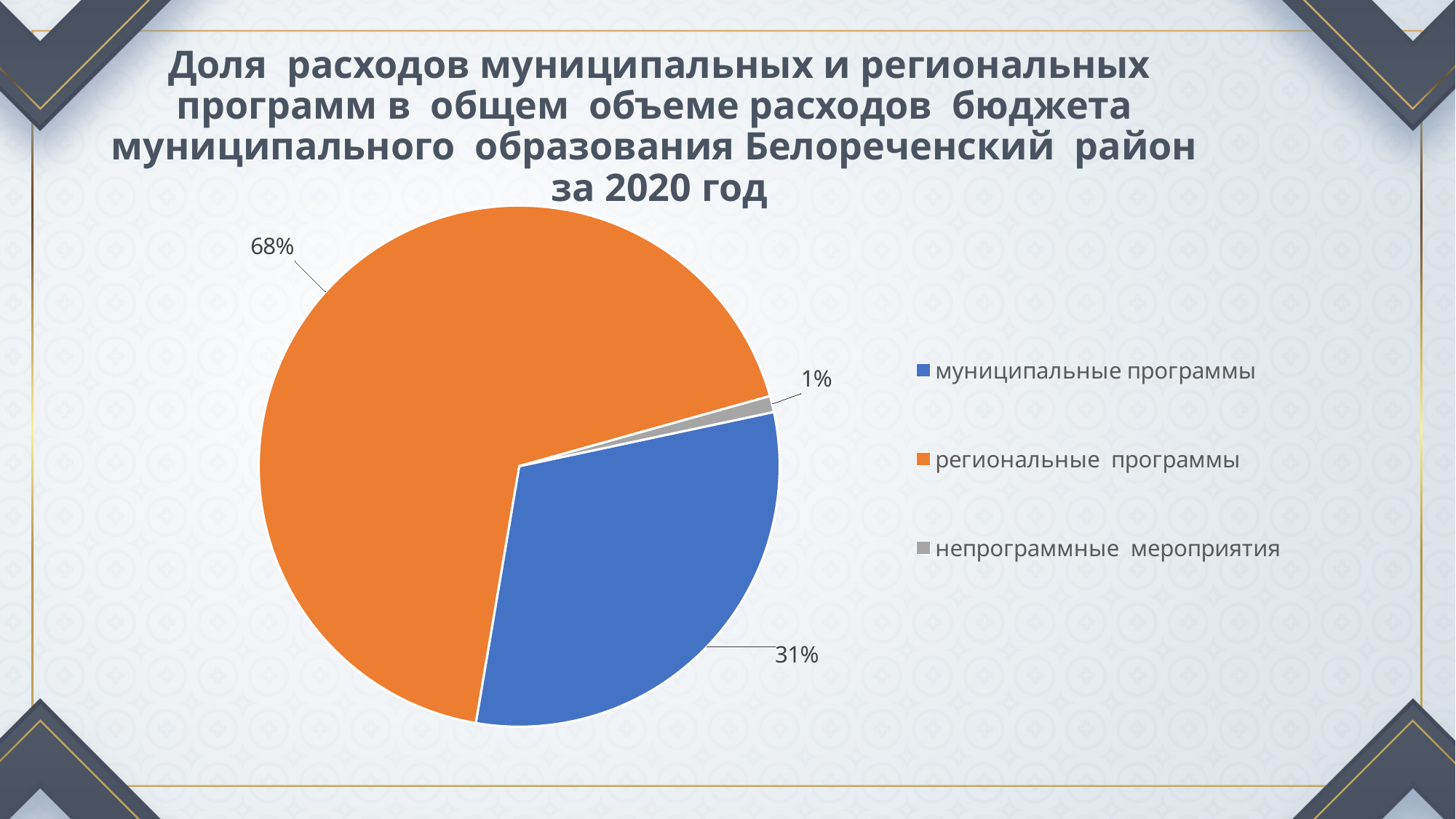
What share of the pie does непрограммные мероприятия have? 1% How many categories does the pie chart show? 3 What colour is the slice for муниципальные программы? blue What is the difference in percentage points between региональные программы and муниципальные программы? 37 What kind of chart is shown on the slide? pie chart Which is larger, the slice for муниципальные программы or the slice for непрограммные мероприятия? муниципальные программы Which category has the smallest slice of the pie? непрограммные мероприятия Which year does the chart title refer to? 2020 What share of the pie does муниципальные программы have? 31% What share of the pie does региональные программы have? 68% Which category has the largest slice of the pie? региональные программы